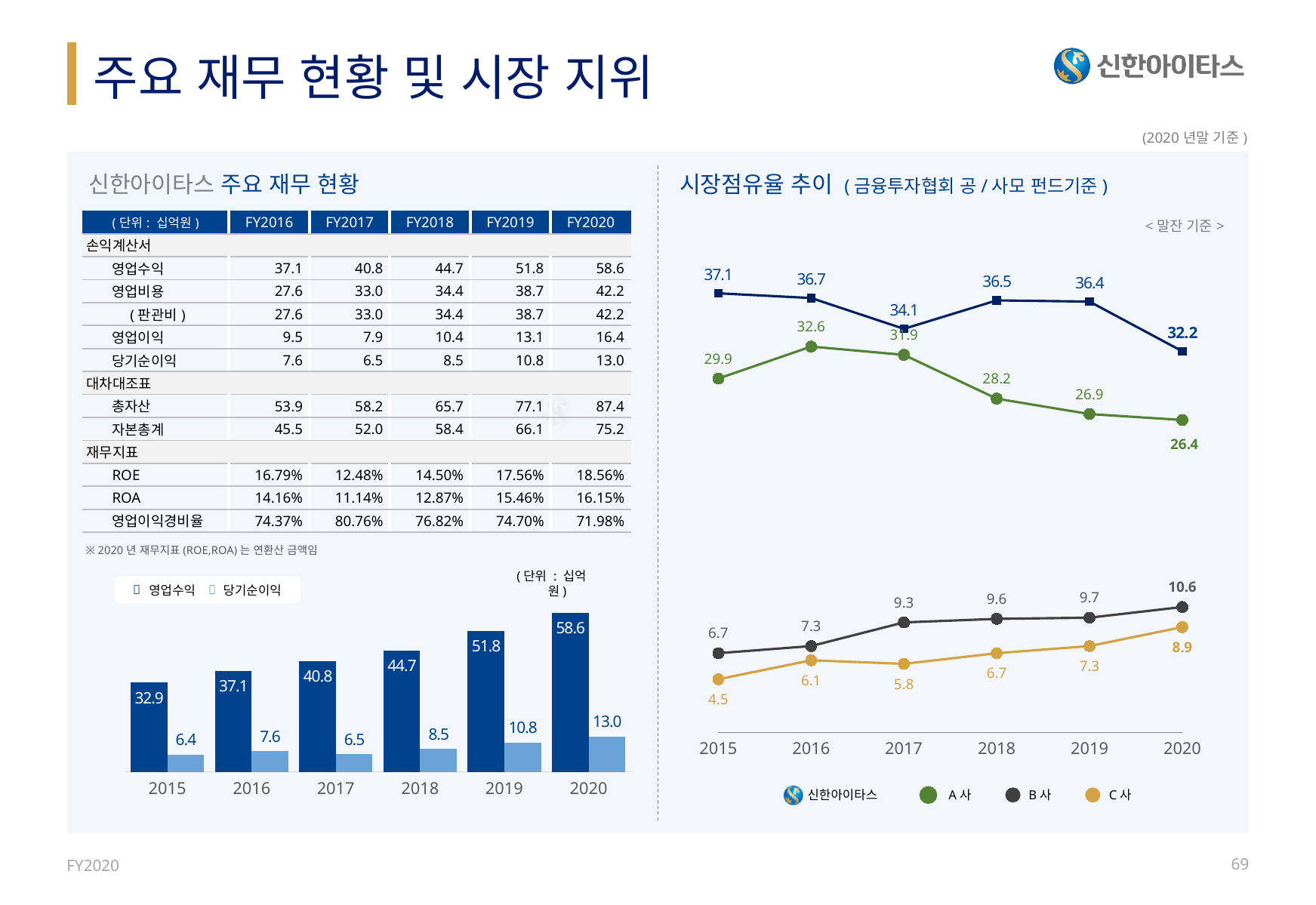
In the line chart titled 시장점유율 추이, what is the value for 신한아이타스 in 2020? 32.2 In the bar chart on the left, how many series does the legend list? 2 In the bar chart on the left, what is the 당기순이익 value for 2017? 6.5 In the bar chart on the left, which year has the lowest 당기순이익? 2015 In the line chart titled 시장점유율 추이, what is the difference between A 사 in 2016 and A 사 in 2020? 6.2 In the line chart titled 시장점유율 추이, which series has the highest value in 2018? 신한아이타스 In the bar chart on the left, what is the 영업수익 value for 2020? 58.6 What kind of chart is the 시장점유율 추이 chart on the right? line chart In the bar chart on the left, which year has the highest 영업수익? 2020 In the line chart titled 시장점유율 추이, what is the value for C 사 in 2015? 4.5 In the bar chart on the left, what is the difference between 영업수익 and 당기순이익 in 2019? 41.0 In the bar chart on the left, does 영업수익 rise or fall from 2015 to 2020? rise